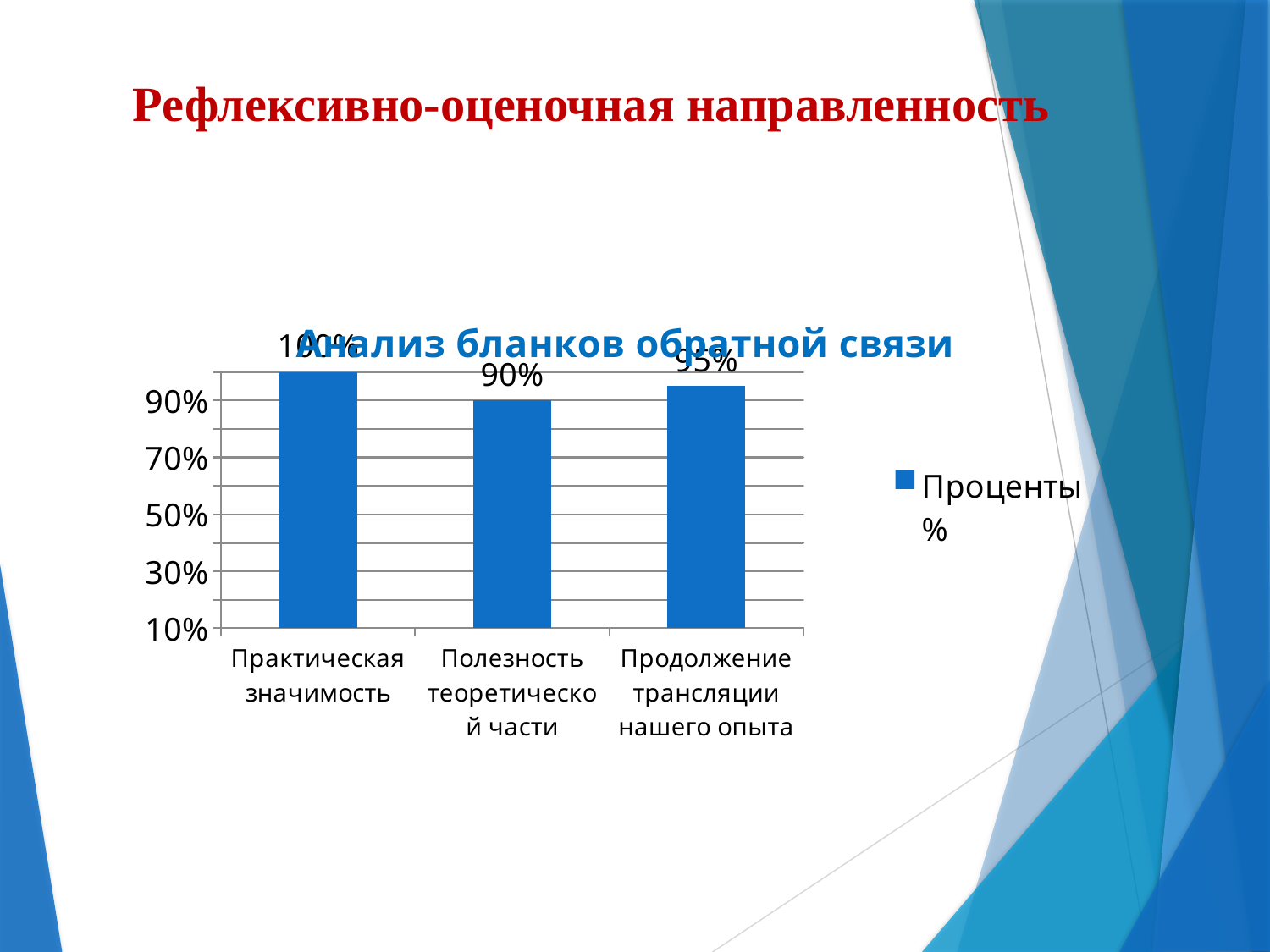
Which category has the highest value? Практическая значимость What is the difference between the values for Практическая значимость and Полезность теоретической части? 10% What is the value for Продолжение трансляции нашего опыта? 95% Which is larger: the value for Продолжение трансляции нашего опыта or the value for Полезность теоретической части? Продолжение трансляции нашего опыта How many series does the legend list? 1 What is the title of the chart? Анализ бланков обратной связи Which category has the lowest value? Полезность теоретической части What is the difference between the values for Продолжение трансляции нашего опыта and Полезность теоретической части? 5% What kind of chart is shown on the slide? bar chart What is the value for Полезность теоретической части? 90% What is the value for Практическая значимость? 100% How many categories are shown in the chart? 3